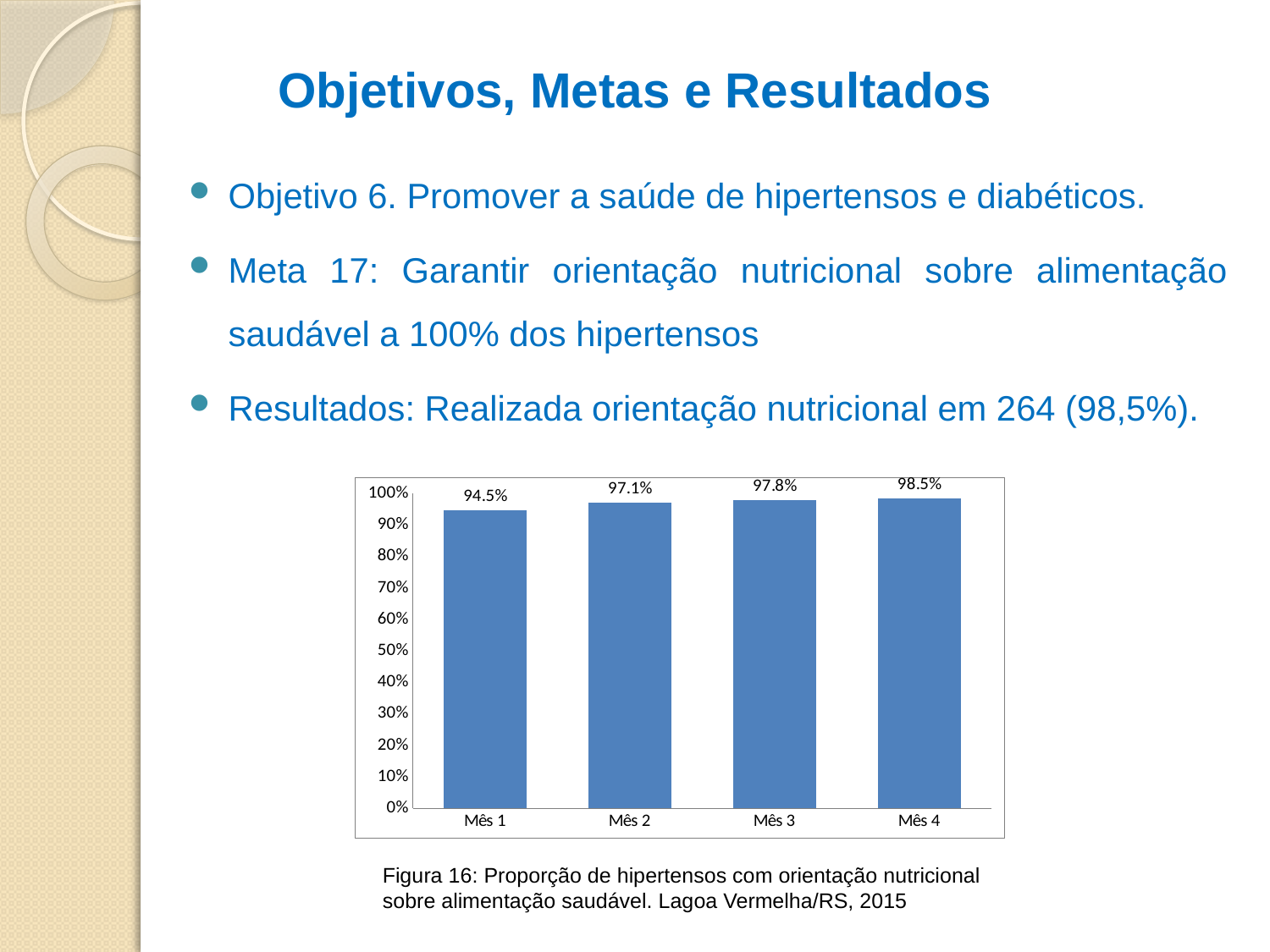
What is the difference between the values for Mês 2 and Mês 1? 2.6% Which month has the lowest value? Mês 1 What is the value for Mês 4? 98.5% What is the difference between the values for Mês 4 and Mês 1? 4.0% Do the values rise or fall from Mês 1 to Mês 4? rise What is the value for Mês 1? 94.5% What is the value for Mês 3? 97.8% Which is larger, the value for Mês 2 or the value for Mês 1? Mês 2 How many months are shown on the x axis? 4 Which month has the highest value? Mês 4 Is the value for Mês 1 greater or less than 90%? greater What kind of chart is shown on the slide? bar chart